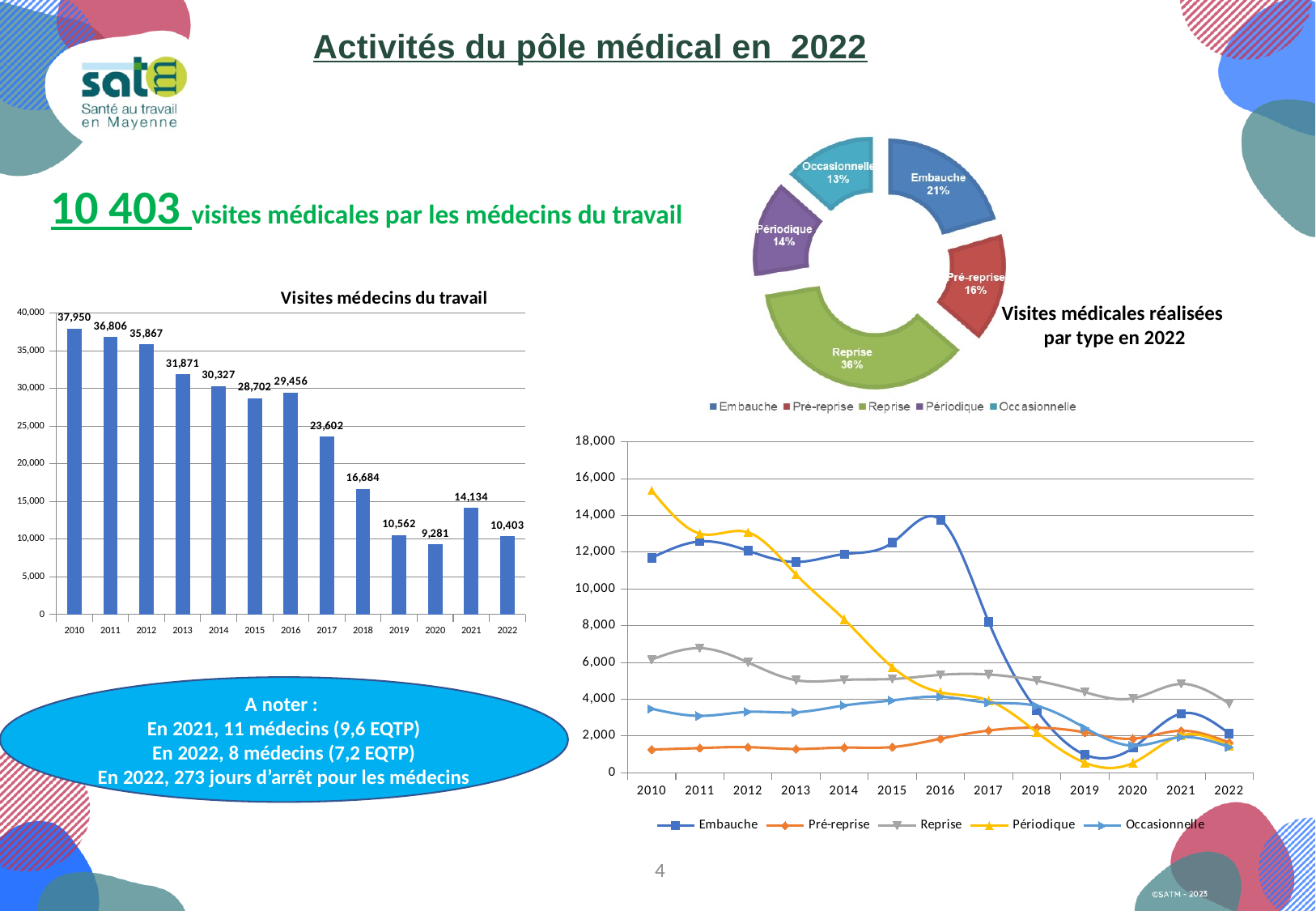
In the 'Visites médicales réalisées par type en 2022' pie chart, which type has the smallest share? Occasionnelle In the 'Visites médecins du travail' bar chart, what is the difference between the values for 2021 and 2022? 3,731 In the 'Visites médecins du travail' bar chart, which is larger, the value for 2015 or the value for 2016? 2016 In the line chart at the bottom right, is the value for Périodique in 2010 greater or less than 14,000? greater In the 'Visites médicales réalisées par type en 2022' pie chart, what share does Reprise have? 36% How many years are shown in the 'Visites médecins du travail' bar chart? 13 In the 'Visites médecins du travail' bar chart, what is the value for 2013? 31,871 In the 'Visites médecins du travail' bar chart, which year has the highest value? 2010 How many series does the legend of the line chart at the bottom right list? 5 In the line chart at the bottom right, does the Embauche series rise or fall between 2016 and 2019? Fall In the 'Visites médecins du travail' bar chart, which year has the lowest value? 2020 What kind of chart is 'Visites médecins du travail'? Bar chart